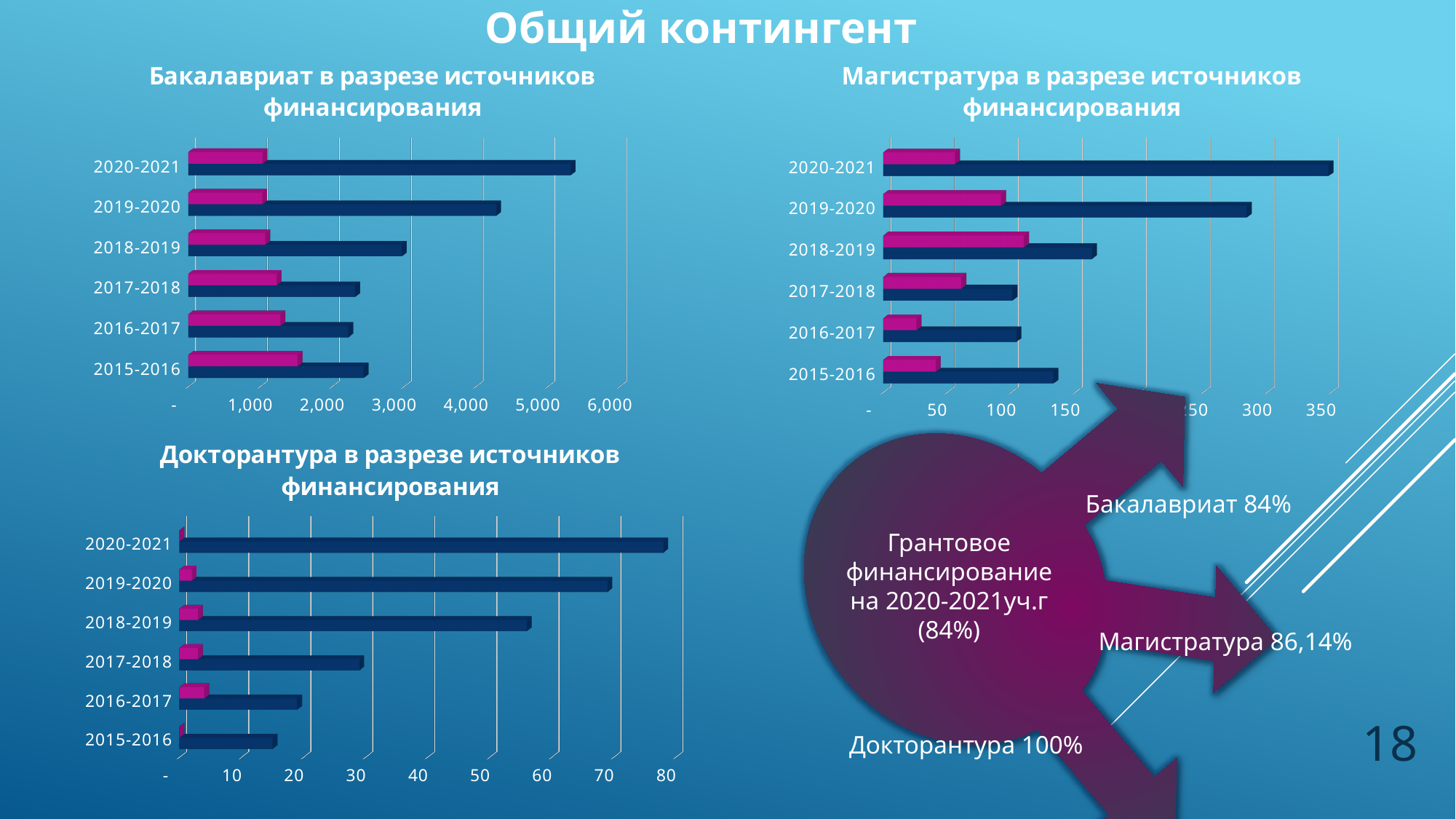
On the 'Бакалавриат в разрезе источников финансирования' chart, which academic year has the longest dark blue bar? 2020-2021 How many academic-year categories are shown on the 'Докторантура в разрезе источников финансирования' chart? 6 On the 'Докторантура в разрезе источников финансирования' chart, do the dark blue bars increase or decrease from 2015-2016 to 2020-2021? increase On the 'Магистратура в разрезе источников финансирования' chart, is the dark blue bar for 2019-2020 greater or less than 250? greater What kind of chart is the 'Бакалавриат в разрезе источников финансирования' chart? bar chart On the 'Докторантура в разрезе источников финансирования' chart, is the dark blue bar for 2018-2019 greater or less than 50? greater On the 'Бакалавриат в разрезе источников финансирования' chart, is the pink bar for 2015-2016 greater or less than 2,000? less On the 'Магистратура в разрезе источников финансирования' chart, which academic year has the shortest pink bar? 2016-2017 On the 'Магистратура в разрезе источников финансирования' chart, which is larger for 2018-2019: the pink bar or the dark blue bar? the dark blue bar On the 'Магистратура в разрезе источников финансирования' chart, which academic year has the longest dark blue bar? 2020-2021 On the 'Докторантура в разрезе источников финансирования' chart, which academic year has the shortest dark blue bar? 2015-2016